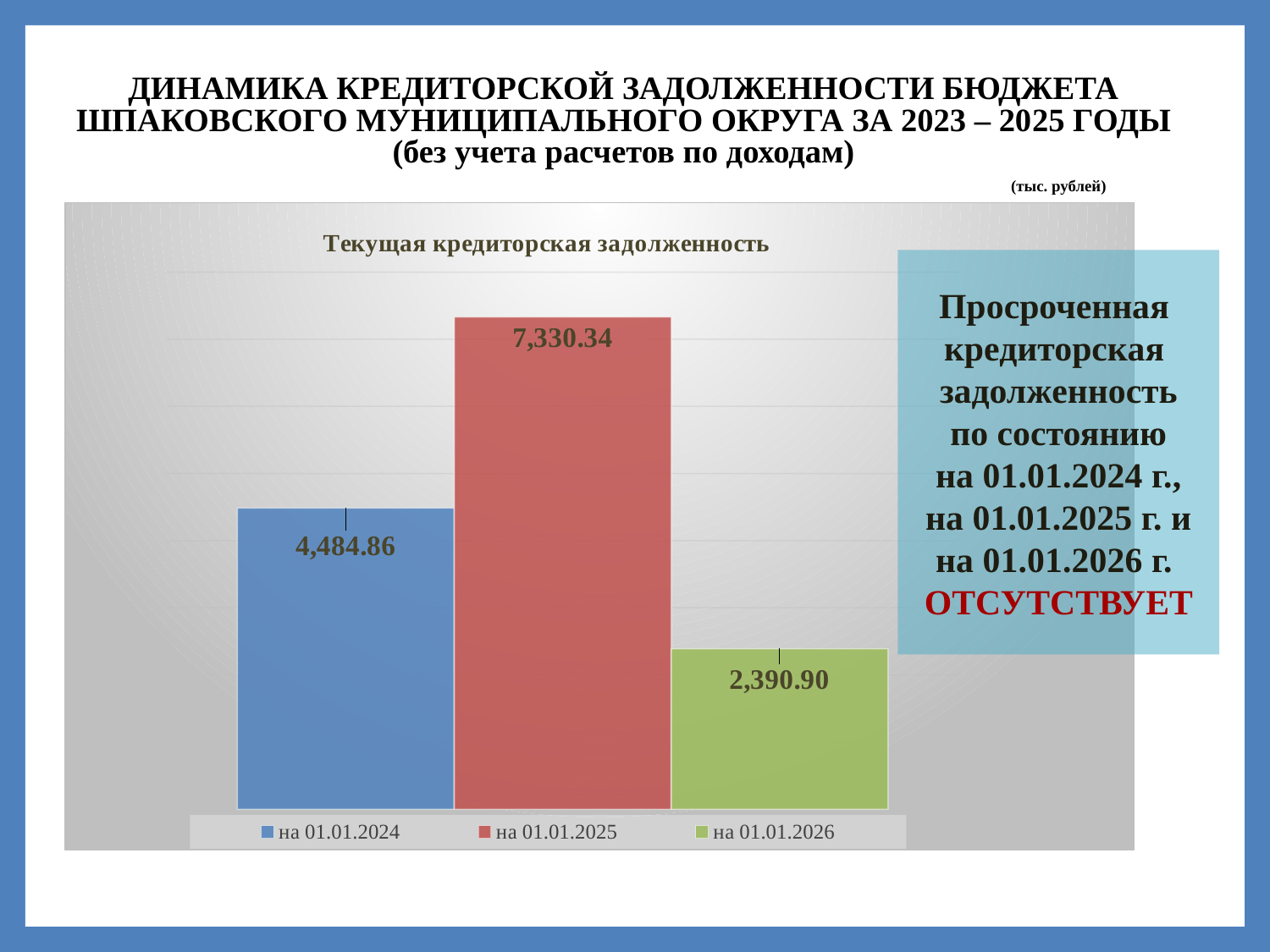
How many entries does the legend list? 3 What is the title of the chart? Текущая кредиторская задолженность What is the current accounts payable value for на 01.01.2024? 4,484.86 Which is larger, the value for на 01.01.2024 or the value for на 01.01.2026? на 01.01.2024 Which date has the highest current accounts payable? на 01.01.2025 What is the current accounts payable value for на 01.01.2026? 2,390.90 What is the difference between the values for на 01.01.2025 and на 01.01.2026? 4,939.44 What is the current accounts payable value for на 01.01.2025? 7,330.34 Which date has the lowest current accounts payable? на 01.01.2026 What is the difference between the values for на 01.01.2025 and на 01.01.2024? 2,845.48 How many bars are plotted in the chart? 3 What kind of chart is shown on the slide? bar chart